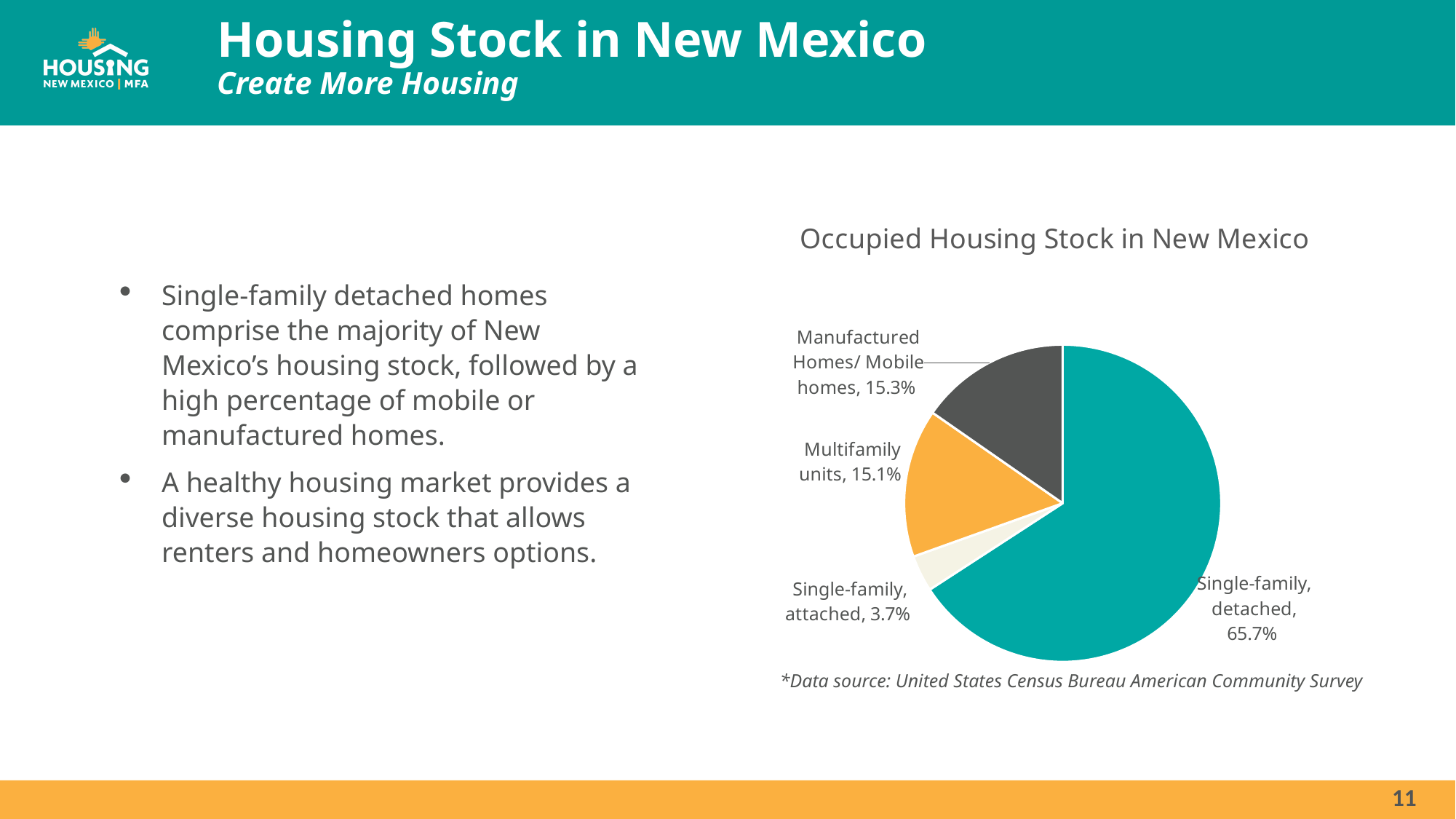
What is the difference in percentage points between Manufactured Homes/ Mobile homes and Single-family, attached? 11.6 Which category has the smallest share of the pie? Single-family, attached What kind of chart is shown on the slide? Pie chart How many categories are shown in the pie chart? 4 What is the title of the chart? Occupied Housing Stock in New Mexico What share of occupied housing stock is Multifamily units? 15.1% What share of occupied housing stock is Single-family, attached? 3.7% What is the difference in percentage points between Single-family, detached and Multifamily units? 50.6 Which category has the largest share of the pie? Single-family, detached What share of occupied housing stock is Manufactured Homes/ Mobile homes? 15.3% What colour is the Single-family, detached slice? Teal What share of occupied housing stock is Single-family, detached? 65.7%